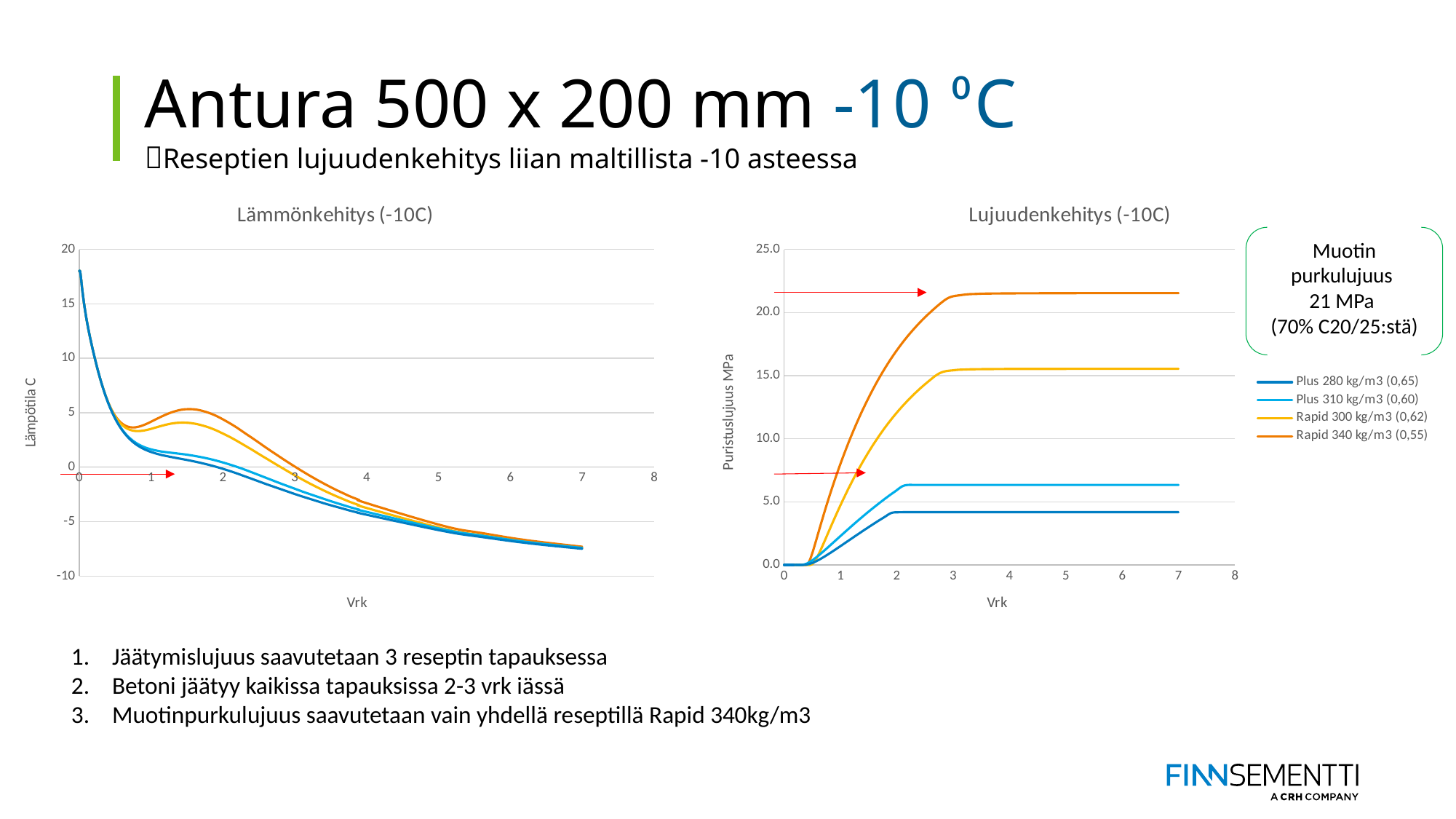
In the Lämmönkehitys (-10C) chart, is the temperature at day 7 greater or less than -5 C? less In the Lujuudenkehitys (-10C) chart, which series reaches the highest compressive strength? Rapid 340 kg/m3 (0,55) In the Lujuudenkehitys (-10C) chart, is the final strength of Rapid 300 kg/m3 (0,62) greater or less than 10.0 MPa? greater In the Lujuudenkehitys (-10C) chart, which series reaches a higher final strength: Rapid 300 kg/m3 (0,62) or Plus 310 kg/m3 (0,60)? Rapid 300 kg/m3 (0,62) In the Lämmönkehitys (-10C) chart, is the temperature at day 0 greater or less than 15 C? greater In the Lämmönkehitys (-10C) chart, do the temperature curves overall rise or fall from day 0 to day 7? fall What kind of chart is the Lujuudenkehitys (-10C) chart? line chart In the Lujuudenkehitys (-10C) chart, which series reaches the lowest compressive strength? Plus 280 kg/m3 (0,65) What is the y-axis label of the Lujuudenkehitys (-10C) chart? Puristuslujuus MPa How many series does the legend of the Lujuudenkehitys (-10C) chart list? 4